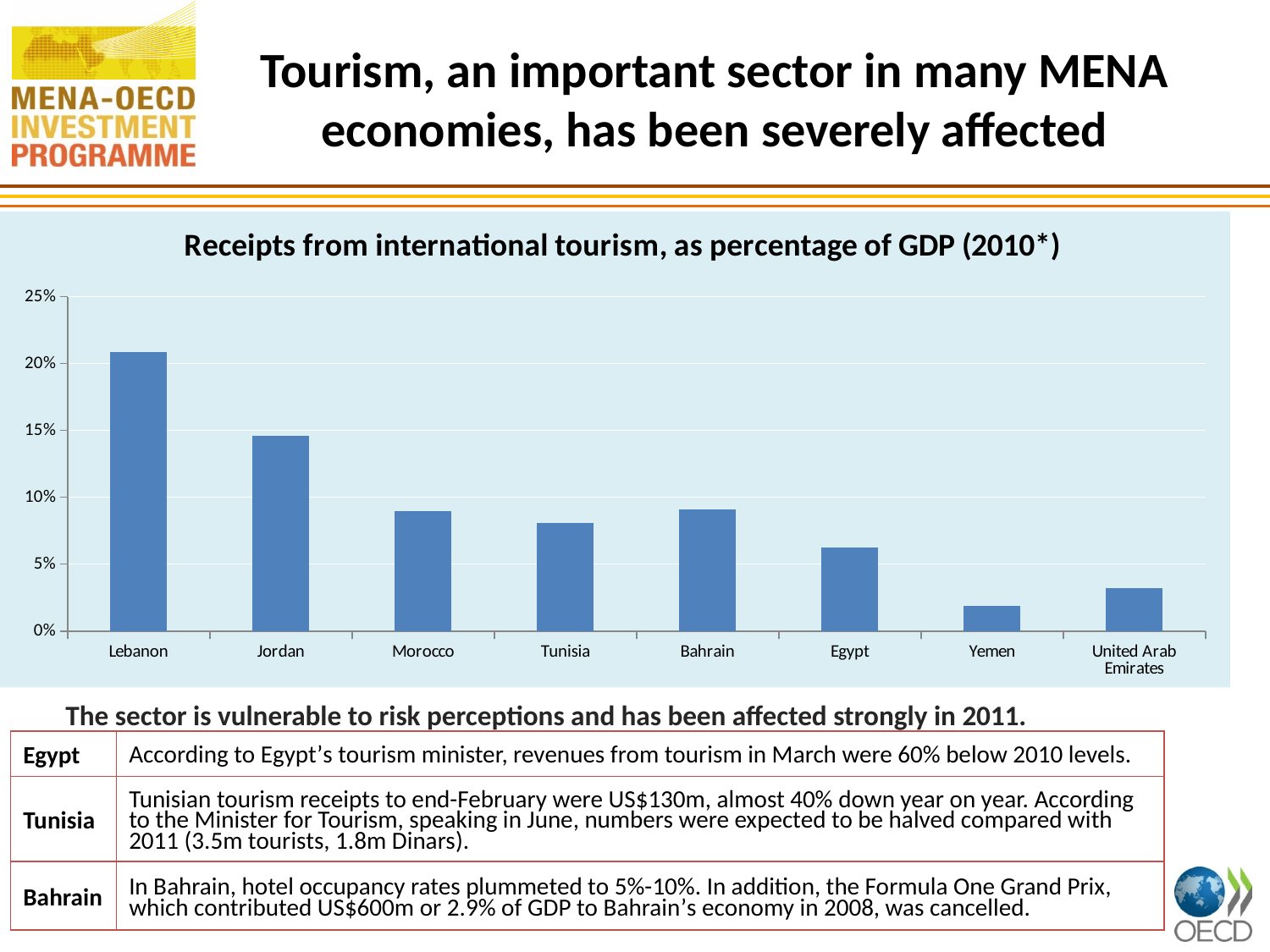
Is the value for Yemen greater or less than 5%? less What is the title of the chart? Receipts from international tourism, as percentage of GDP (2010*) Which country has the highest receipts from international tourism as a percentage of GDP? Lebanon Is the value for United Arab Emirates greater or less than 5%? less Which has a higher value, Egypt or United Arab Emirates? Egypt What type of chart is shown on the slide? Bar chart Is the value for Jordan greater or less than 10%? greater Which country has the lowest receipts from international tourism as a percentage of GDP? Yemen How many countries are shown in the chart? 8 Which has a higher value, Lebanon or Jordan? Lebanon